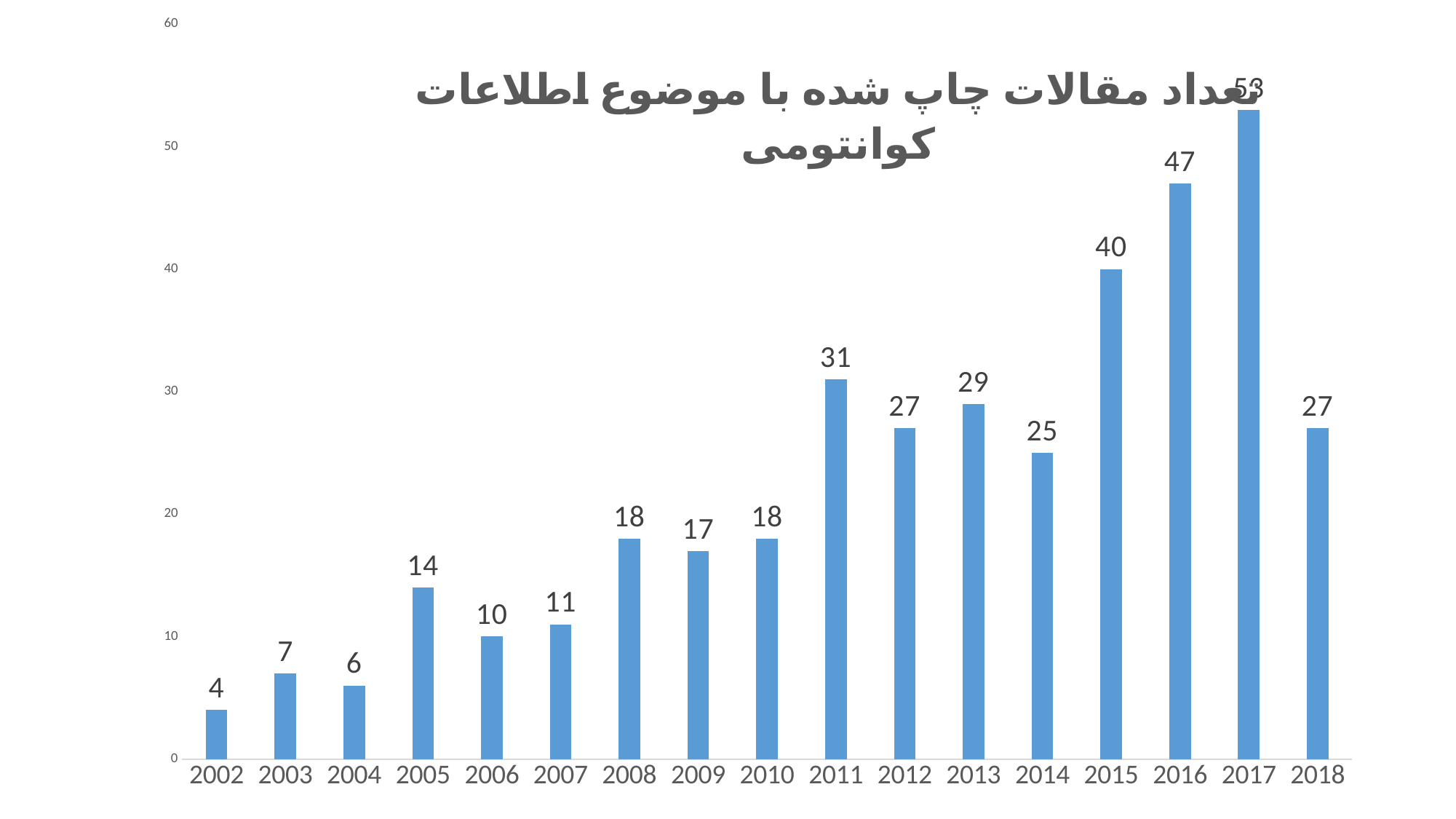
What is the value for 2015? 40 Do the values generally rise or fall from 2002 to 2017? rise Is the value for 2016 greater or less than 40? greater How many years are shown on the x axis? 17 What kind of chart is this? bar chart Which year has the lowest value? 2002 What is the difference between the values for 2017 and 2016? 6 What is the value for 2018? 27 Which is larger, the value for 2013 or the value for 2014? 2013 Which year has the highest value? 2017 What is the value for 2008? 18 What is the difference between the values for 2011 and 2005? 17